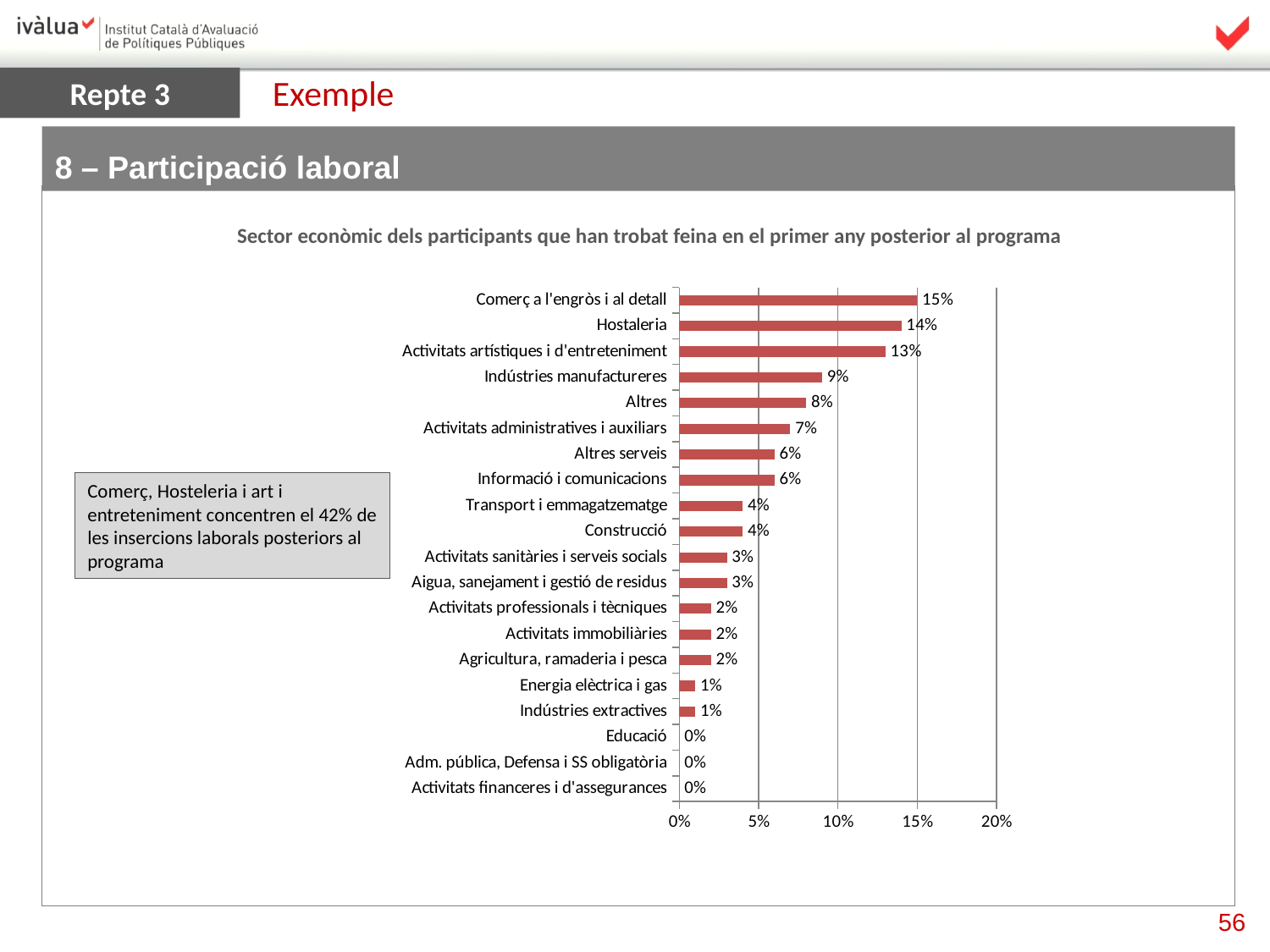
Which is larger, the value for Altres or the value for Activitats administratives i auxiliars? Altres What is the value for Construcció? 4% What kind of chart is shown on the slide? bar chart Is the value for Comerç a l'engròs i al detall greater or less than 10%? greater What is the value for Indústries manufactureres? 9% How many categories are shown on the chart? 20 What is the value for Hostaleria? 14% What is the title of the chart? Sector econòmic dels participants que han trobat feina en el primer any posterior al programa What is the value for Educació? 0% What is the difference between the values for Comerç a l'engròs i al detall and Activitats artístiques i d'entreteniment? 2% Which category has the highest value? Comerç a l'engròs i al detall What is the highest value shown on the x axis? 20%